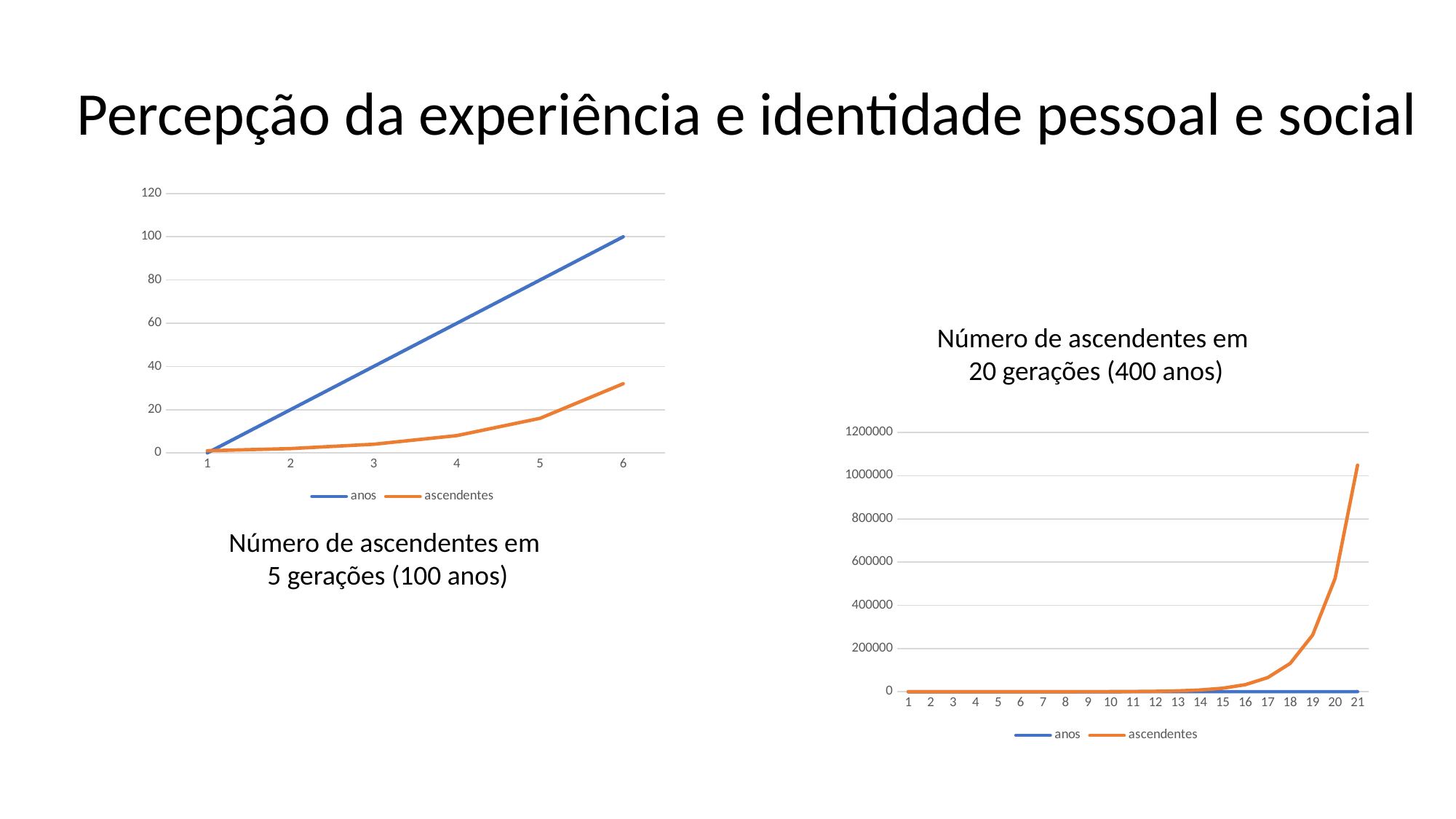
How many points are on the x axis of the right chart, 'Número de ascendentes em 20 gerações (400 anos)'? 21 What kind of chart is the left chart, 'Número de ascendentes em 5 gerações (100 anos)'? line chart In the left chart, what is the value of the 'anos' series at point 6? 100 How many series does the legend of the left chart list? 2 In the left chart, is the value of 'ascendentes' at point 6 greater or less than 40? less In the right chart, at which x-axis point does the 'ascendentes' series reach its highest value? 21 In the right chart, is the value of 'ascendentes' at point 21 greater or less than 1000000? greater In the right chart, does the 'ascendentes' series rise or fall along the x axis? rise In the left chart, which series is higher at point 6, 'anos' or 'ascendentes'? anos What are the two series named in the legend of the right chart? anos and ascendentes What kind of chart is the right chart, 'Número de ascendentes em 20 gerações (400 anos)'? line chart How many points are on the x axis of the left chart, 'Número de ascendentes em 5 gerações (100 anos)'? 6